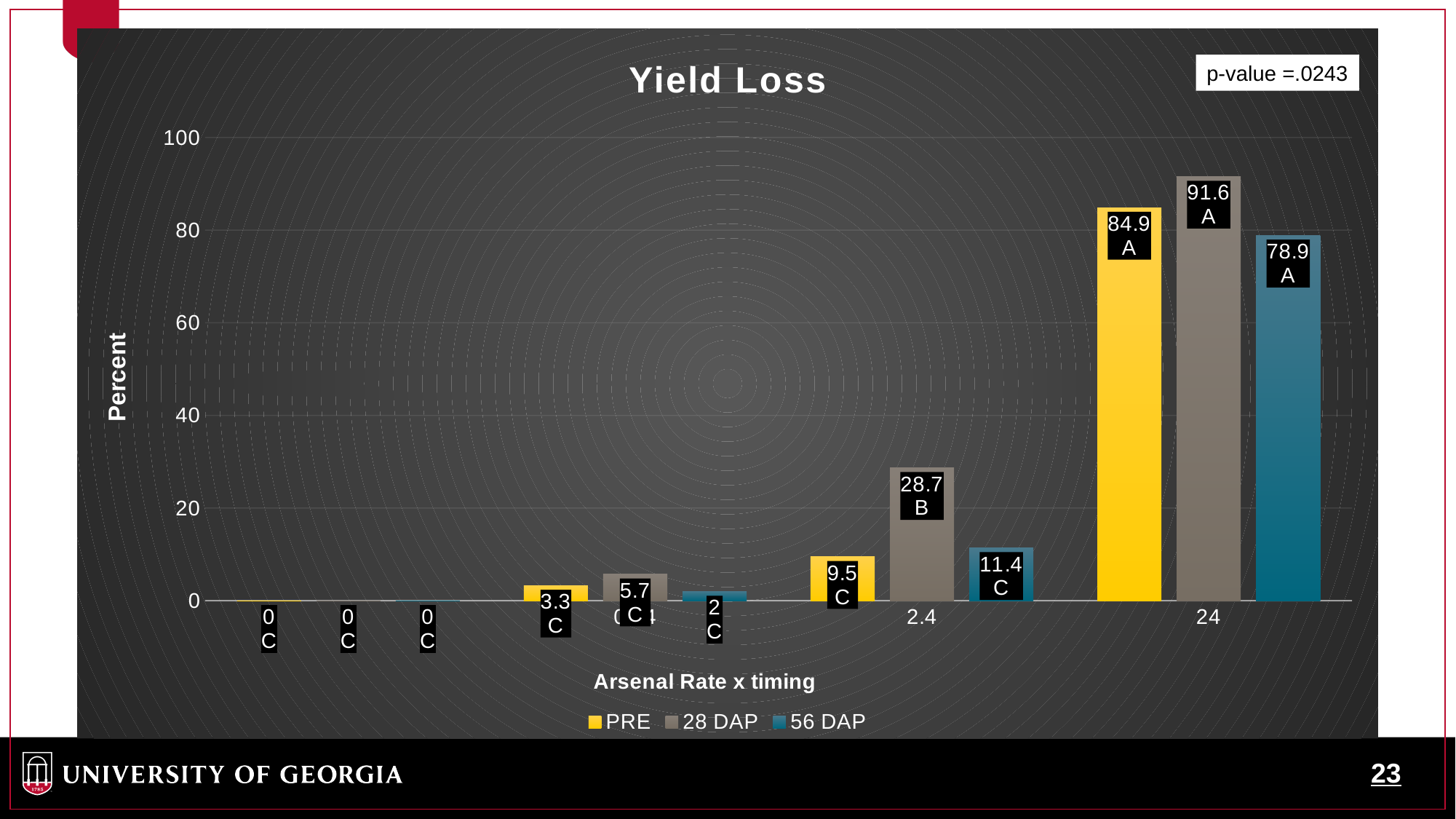
What is the yield loss value for the 28 DAP series at the 2.4 rate? 28.7 At the 2.4 rate, which is larger: the PRE value or the 56 DAP value? 56 DAP Is the 28 DAP value at the 24 rate greater or less than 80? greater At the 2.4 rate, which series has the lowest yield loss? PRE What is the yield loss value for the 56 DAP series at the 24 rate? 78.9 At the 2.4 rate, what is the difference between the 28 DAP value and the 56 DAP value? 17.3 How many series does the legend list? 3 What p-value is shown on the chart? .0243 What is the yield loss value for the PRE series at the 24 rate? 84.9 At the 24 rate, what is the difference between the 28 DAP value and the PRE value? 6.7 What kind of chart is shown on the slide? bar chart At the 24 rate, which series has the highest yield loss? 28 DAP